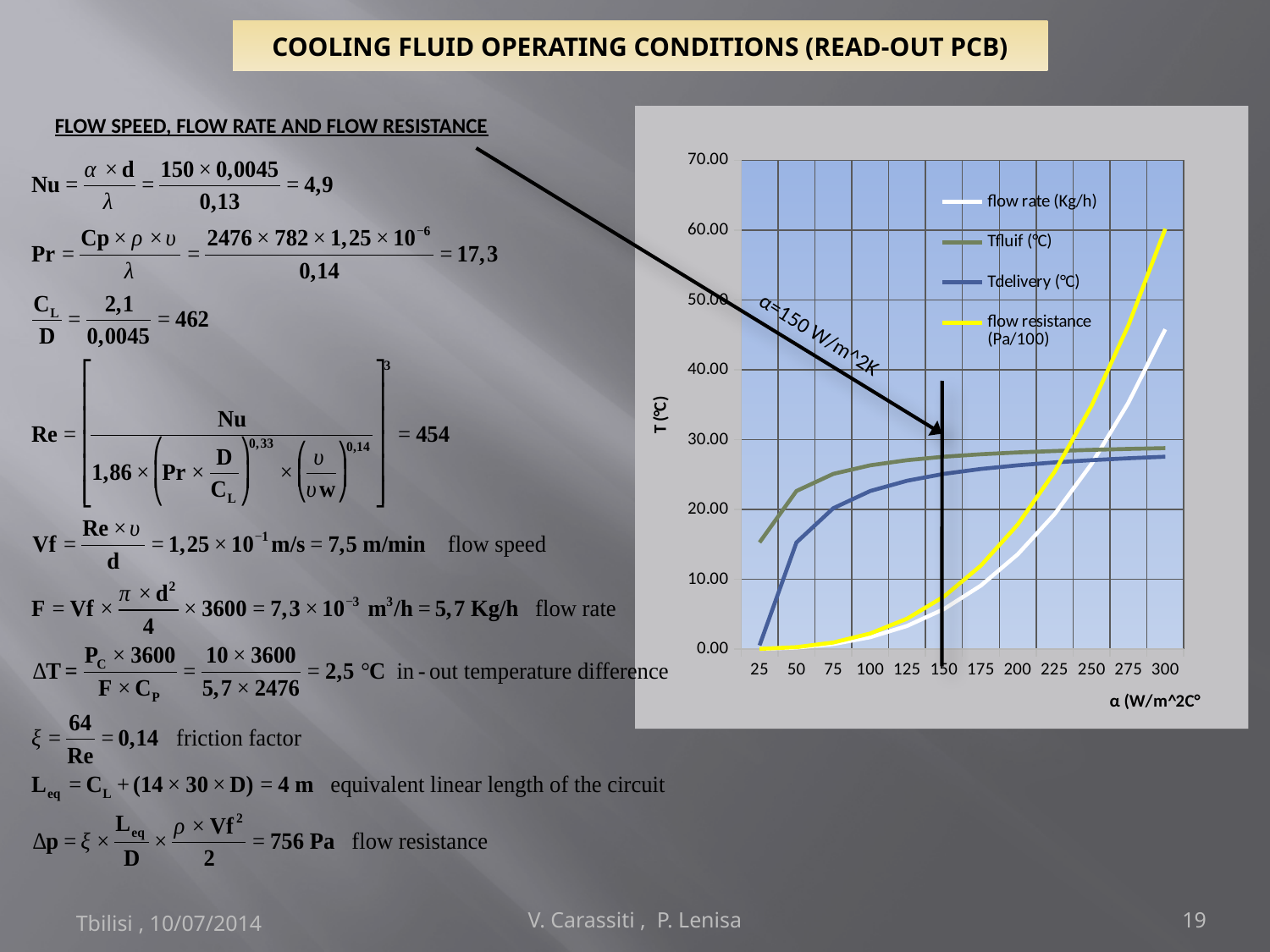
Is the value of Tfluif (°C) at α = 25 greater or less than 10? greater Is the value of Tdelivery (°C) at α = 25 greater or less than 10? less At which α value is the vertical marker line drawn on the chart? 150 How many α values are labelled along the x axis of the chart? 12 At α = 50, which is higher: Tfluif (°C) or Tdelivery (°C)? Tfluif (°C) Is the value of flow resistance (Pa/100) at α = 300 greater or less than 50? greater Which series has the highest value at α = 300 W/m^2C°? flow resistance (Pa/100) Does the flow resistance (Pa/100) series rise or fall as α increases along the x axis? rise How many series does the chart legend list? 4 What is the label of the chart's y axis? T (°C) What kind of chart is shown on the slide? line chart